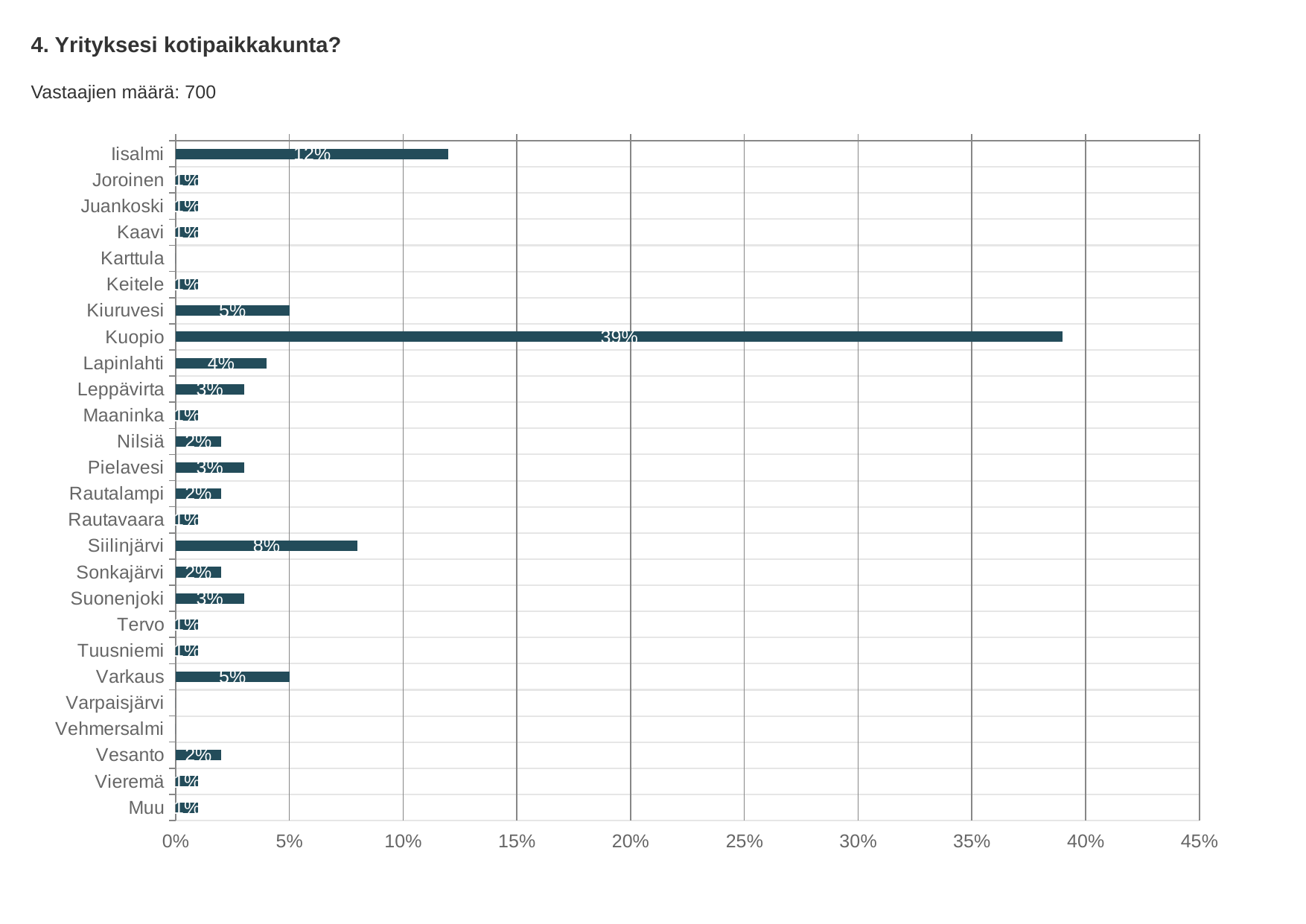
Which category has the highest value? Kuopio How many categories are listed on the vertical axis? 26 Is the value for Kuopio greater or less than 35%? greater What is the value for Kuopio? 39% What is the difference between the values for Kuopio and Iisalmi? 27% What is the value for Siilinjärvi? 8% What is the value for Iisalmi? 12% What kind of chart is shown on the slide? bar chart Which is larger, the value for Varkaus or the value for Leppävirta? Varkaus What is the value for Lapinlahti? 4% What is the difference between the values for Siilinjärvi and Kiuruvesi? 3% What is the title of the chart? 4. Yrityksesi kotipaikkakunta?